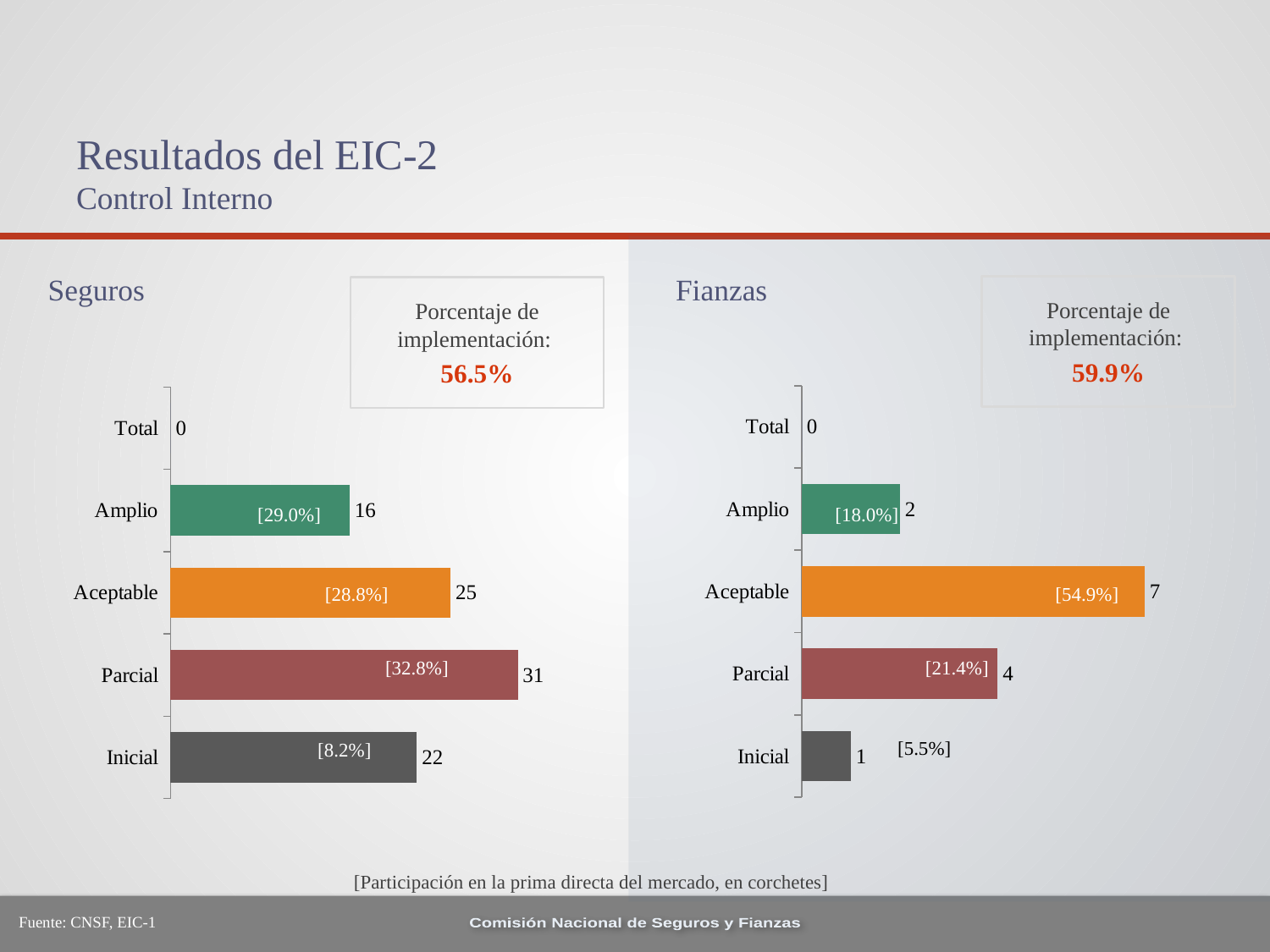
In the Fianzas chart, what is the value for Aceptable? 7 What type of chart is the Fianzas chart? Bar chart In the Seguros chart, what is the difference between the values for Parcial and Inicial? 9 In the Fianzas chart, what market share in brackets is shown for Inicial? [5.5%] In the Fianzas chart, which category has the highest value? Aceptable In the Fianzas chart, which category has the lowest value? Total In the Fianzas chart, which is larger, the value for Parcial or the value for Amplio? Parcial In the Seguros chart, what is the value for Parcial? 31 In the Seguros chart, what market share in brackets is shown for Aceptable? [28.8%] How many categories does the Seguros chart show? 5 In the Seguros chart, which category has the highest value? Parcial What is the Porcentaje de implementación shown for Seguros? 56.5%